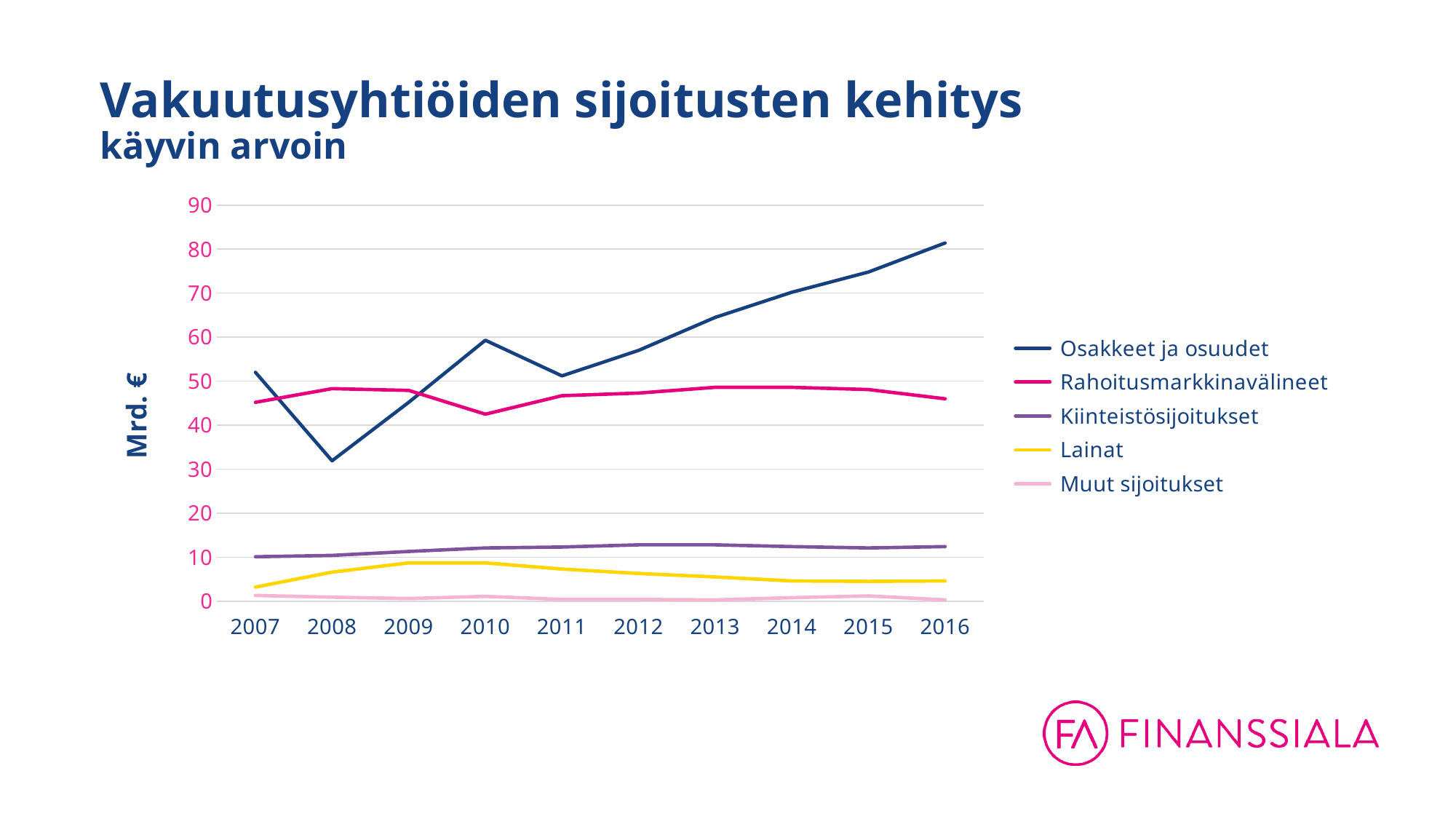
How many years are shown on the x axis? 10 Is the value for Kiinteistösijoitukset in 2013 greater or less than 10? greater What kind of chart is shown on the slide? line chart In which year does Osakkeet ja osuudet reach its lowest value? 2008 In 2008, which is larger: Rahoitusmarkkinavälineet or Osakkeet ja osuudet? Rahoitusmarkkinavälineet How many series does the legend list? 5 Which series has the highest value in 2016? Osakkeet ja osuudet Is the value for Osakkeet ja osuudet in 2016 greater or less than 70? greater Does the Osakkeet ja osuudet line rise or fall from 2011 to 2016? rise What is the label on the y axis? Mrd. € Which series has the lowest value in 2016? Muut sijoitukset Is the value for Osakkeet ja osuudet in 2008 greater or less than 40? less